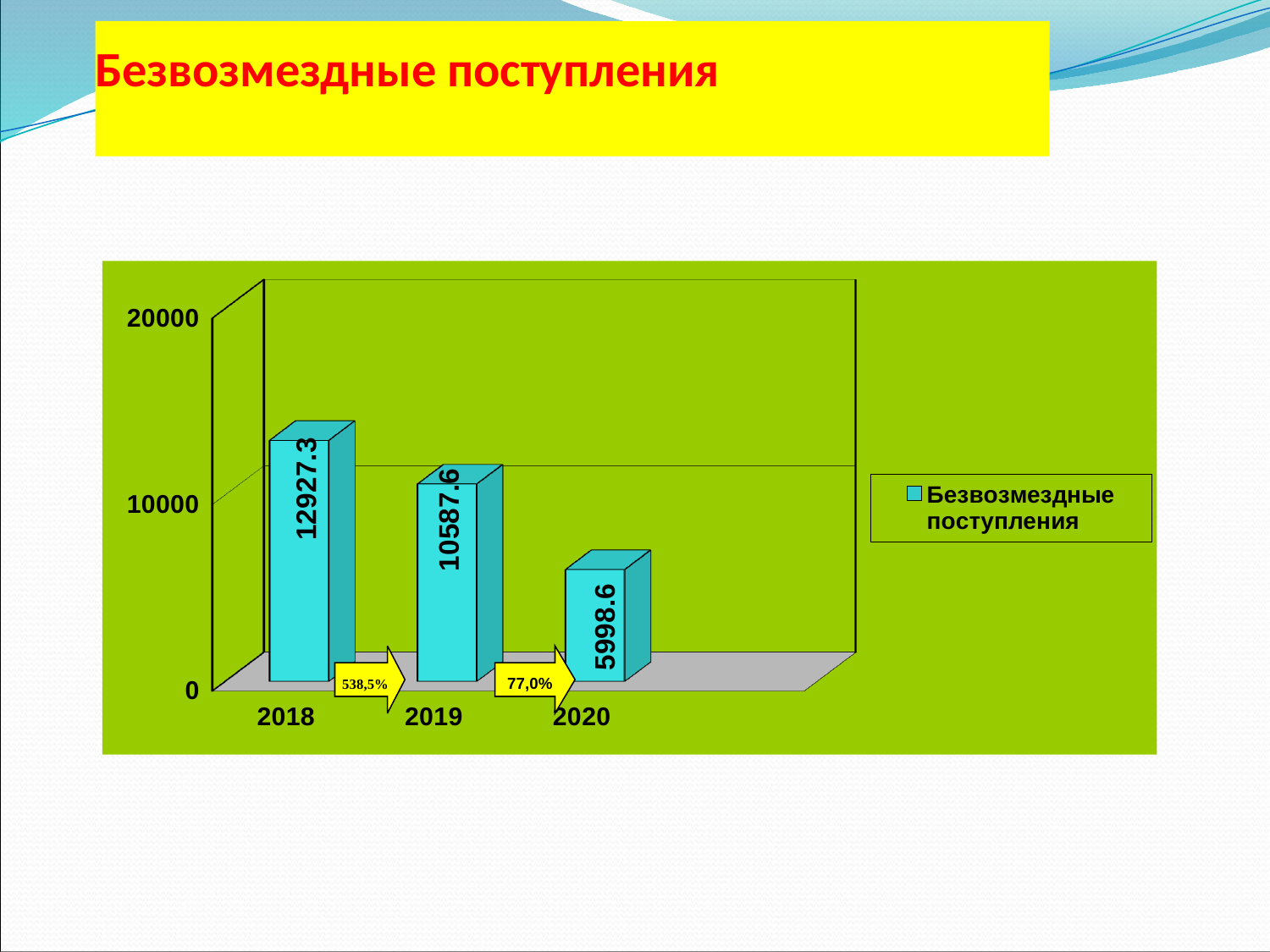
Which year has the highest value? 2018 Do the values rise or fall from 2018 to 2020? fall What is the difference between the values for 2018 and 2019? 2339.7 What is the value for 2020? 5998.6 How many years are shown on the x axis? 3 What is the difference between the values for 2019 and 2020? 4589 What is the value for 2019? 10587.6 What kind of chart is shown on the slide? bar chart What is the value for 2018? 12927.3 Which is larger, the value for 2019 or the value for 2020? 2019 Is the value for 2020 greater or less than 10000? less Which year has the lowest value? 2020